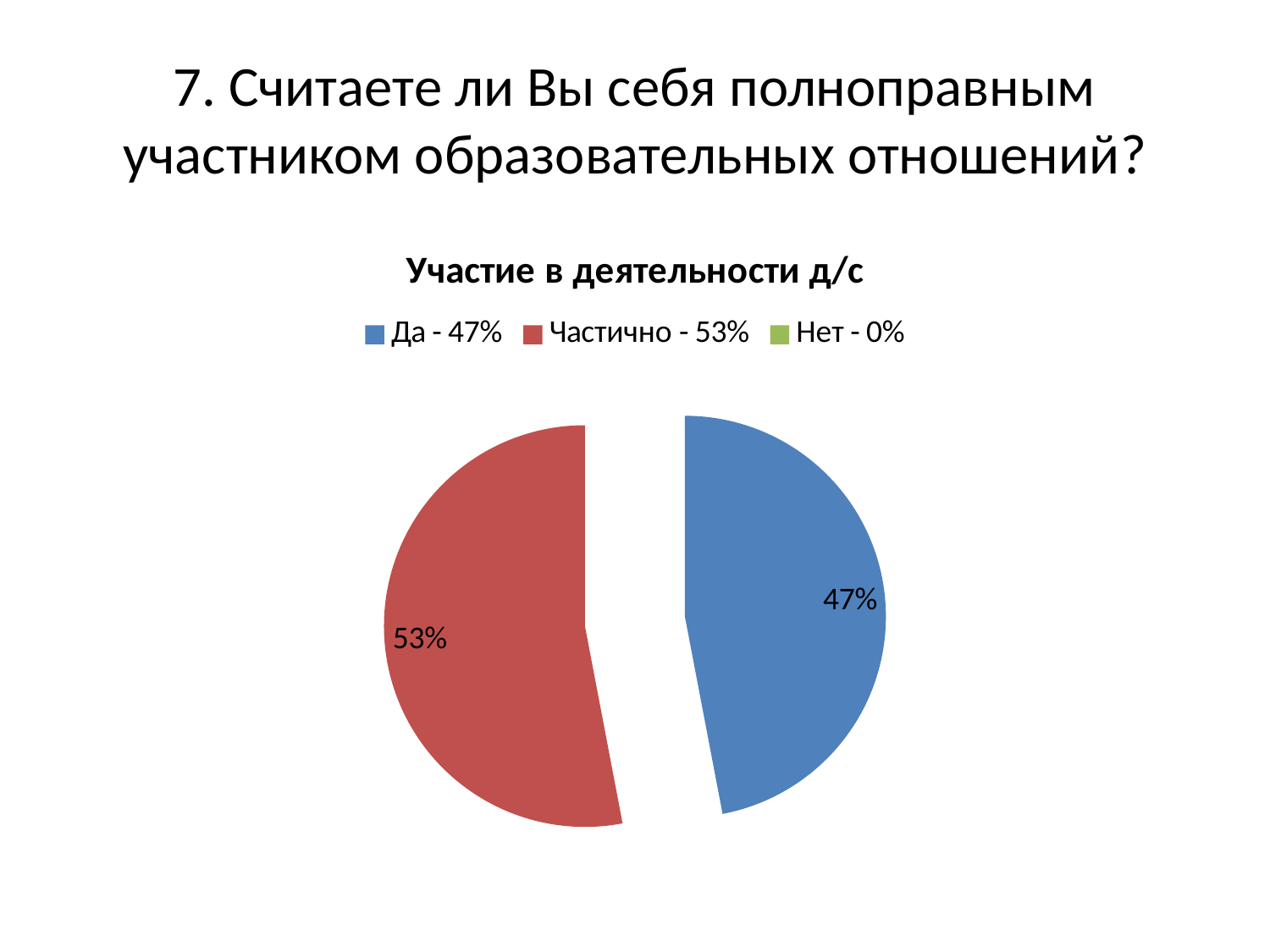
What type of chart is shown on the slide? pie chart How many slices are visible in the pie? 2 How many entries does the legend list? 3 What share of the pie does the "Частично" slice represent? 53% What share of the pie does the "Да" slice represent? 47% What percentage is shown for "Нет" in the legend? 0% What is the difference between the "Частично" share and the "Да" share? 6% Which category has the smallest share according to the legend? Нет What colour is the "Да" slice? blue Which is larger, the share for "Да" or the share for "Частично"? Частично What is the title of the chart? Участие в деятельности д/с Which category has the largest share of the pie? Частично